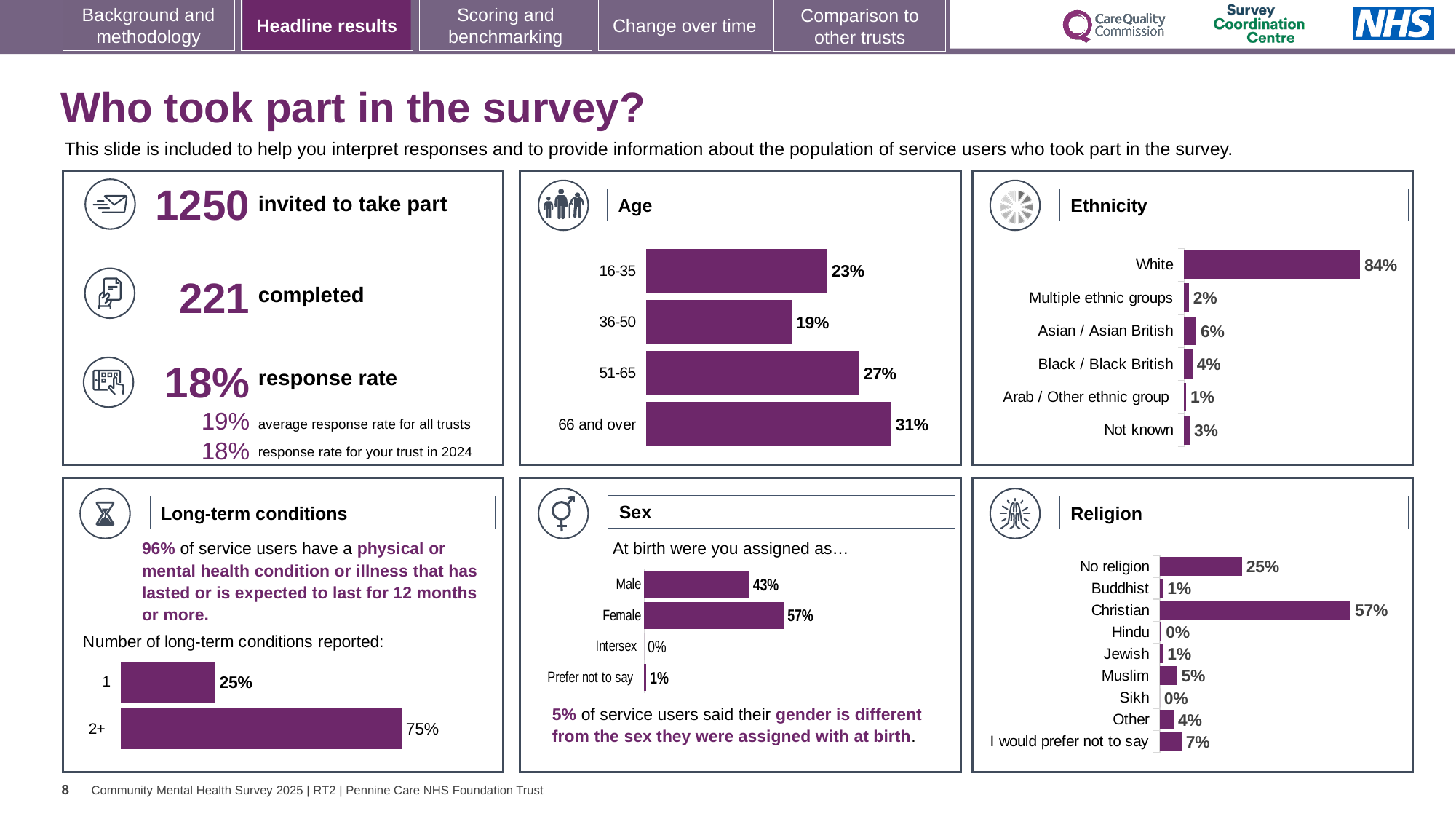
In the Religion chart, which religion category has the highest percentage? Christian In the Age chart, which age group has the lowest percentage? 36-50 In the Sex chart, which is larger, Male or Female? Female In the Sex chart, what percentage of respondents were assigned Female at birth? 57% In the Age chart, what percentage of respondents were aged 66 and over? 31% In the Long-term conditions chart, what percentage of service users reported 2+ long-term conditions? 75% What type of chart is used in the Age panel? Bar chart In the Religion chart, what percentage of respondents were Muslim? 5% In the Ethnicity chart, which category has the lowest percentage? Arab / Other ethnic group In the Ethnicity chart, what is the difference between the Asian / Asian British and Black / Black British percentages? 2% In the Age chart, how many age categories are shown? 4 In the Ethnicity chart, what percentage of respondents were White? 84%